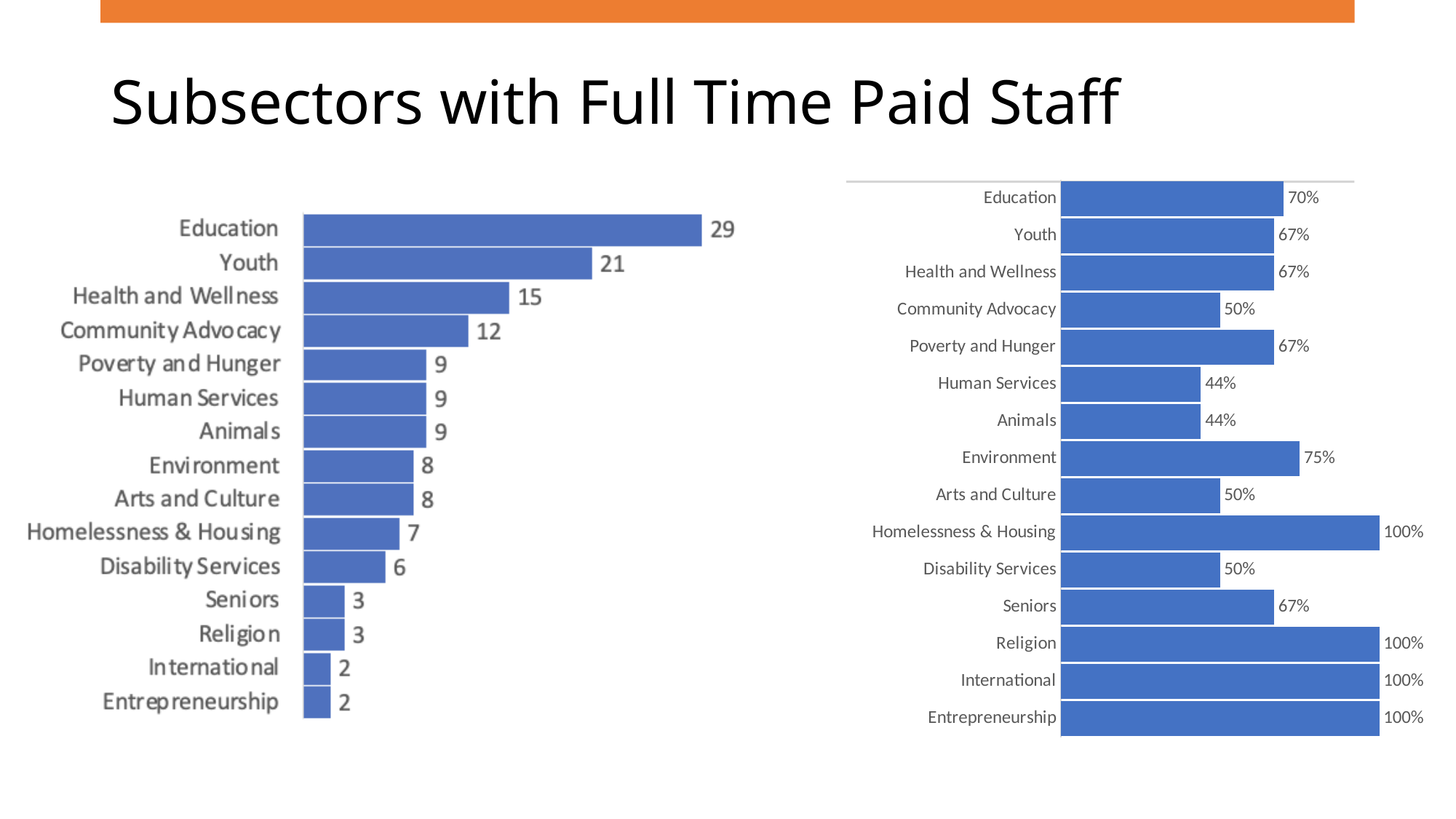
What is the title of the slide? Subsectors with Full Time Paid Staff In the left chart, what is the difference between the values for Education and Youth? 8 In the right chart, which category has the lowest value? Human Services and Animals (44%) In the left chart, which category has the highest value? Education In the right chart, what is the value for Seniors? 67% In the left chart, what is the value for Education? 29 How many categories are shown in the left chart? 15 What kind of chart is the right chart? Bar chart In the right chart, which is larger, the value for Education or the value for Community Advocacy? Education In the left chart, which is larger, the value for Health and Wellness or the value for Community Advocacy? Health and Wellness In the right chart, what is the value for Environment? 75% In the left chart, what is the value for Disability Services? 6